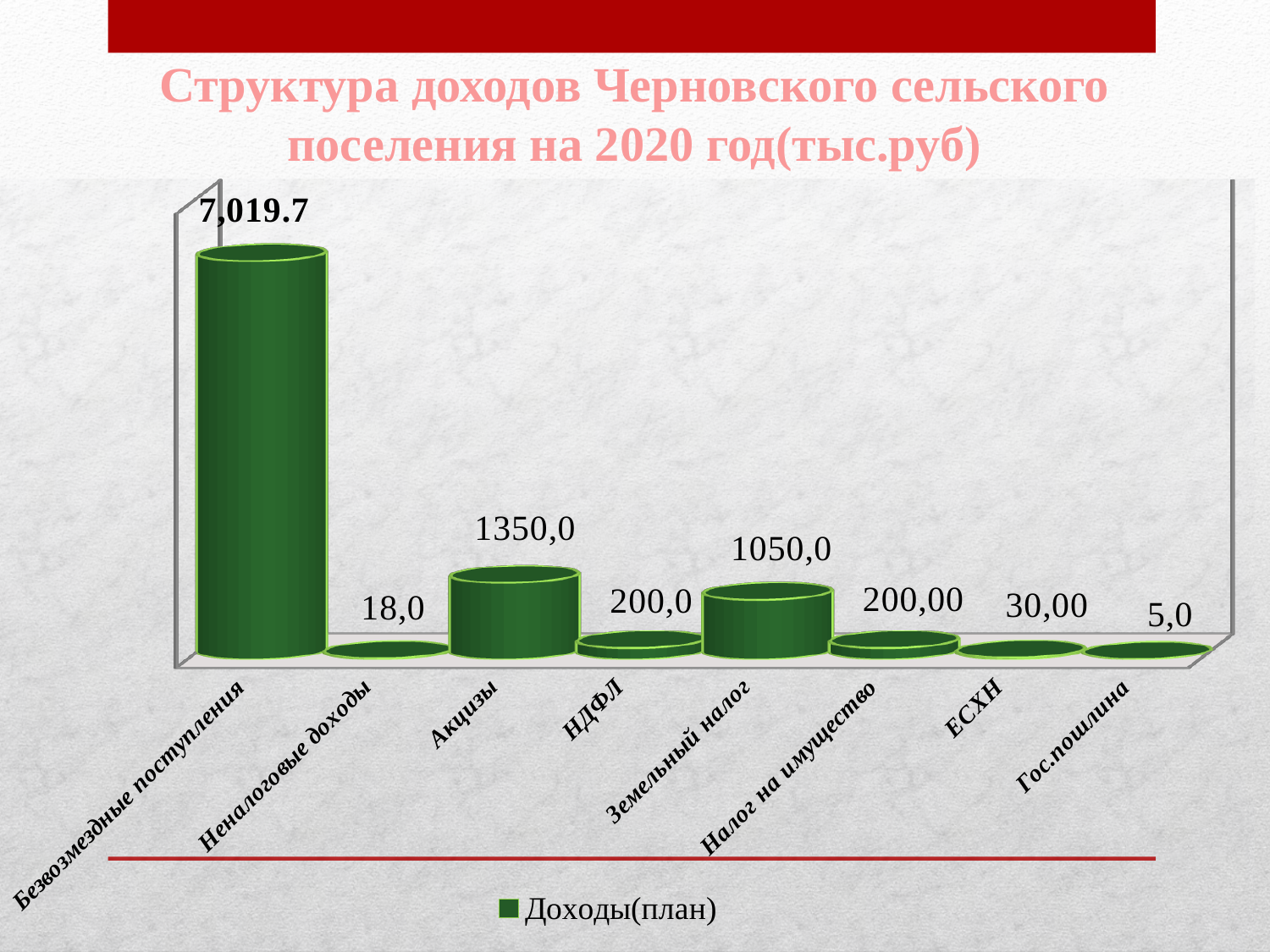
How many series does the legend list? 1 Which category has the highest value? Безвозмездные поступления Which is larger, the value for Неналоговые доходы or the value for ЕСХН? ЕСХН How many categories are shown on the x axis? 8 What is the value for ЕСХН? 30,00 What is the difference between the values for Акцизы and Земельный налог? 300,0 What is the value for Безвозмездные поступления? 7,019.7 Which category has the lowest value? Гос.пошлина What is the value for Земельный налог? 1050,0 What kind of chart is shown on the slide? Bar chart What is the value for Гос.пошлина? 5,0 What is the value for Акцизы? 1350,0